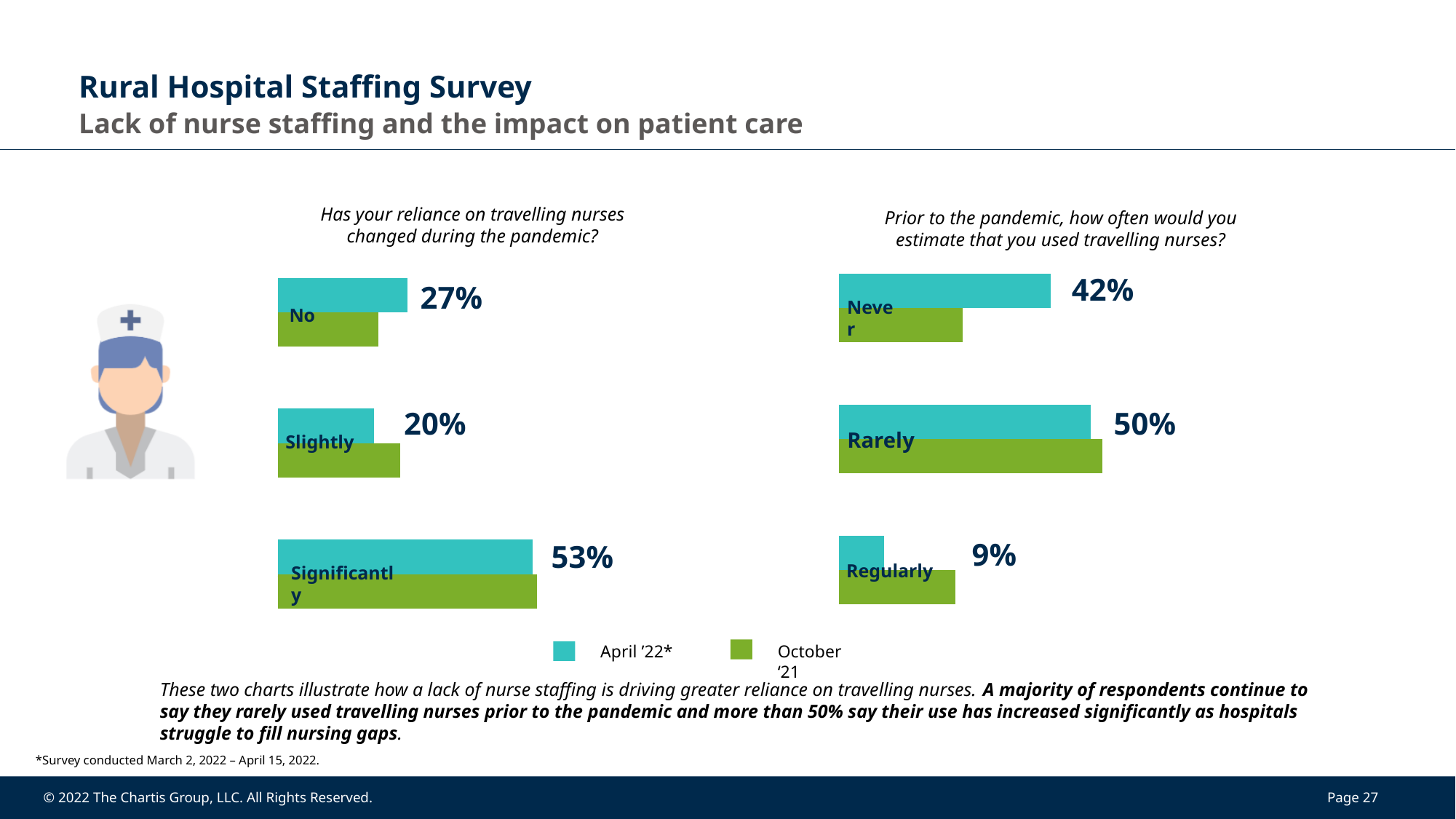
In the right chart (Prior to the pandemic, how often would you estimate that you used travelling nurses?), what is the April '22 value for Rarely? 50% In the left chart (Has your reliance on travelling nurses changed during the pandemic?), what is the April '22 value for No? 27% In the left chart (Has your reliance on travelling nurses changed during the pandemic?), which category has the highest labelled April '22 value? Significantly In the right chart (Prior to the pandemic, how often would you estimate that you used travelling nurses?), what is the difference between the labelled values for Rarely and Never? 8% In the right chart (Prior to the pandemic, how often would you estimate that you used travelling nurses?), which category has the lowest labelled April '22 value? Regularly In the left chart (Has your reliance on travelling nurses changed during the pandemic?), what is the April '22 value for Significantly? 53% How many series does the legend shared by the two charts list? 2 In the right chart (Prior to the pandemic, how often would you estimate that you used travelling nurses?), what is the April '22 value for Regularly? 9% What kind of chart is the right chart (Prior to the pandemic, how often would you estimate that you used travelling nurses?)? Bar chart In the right chart (Prior to the pandemic, how often would you estimate that you used travelling nurses?), which is larger for April '22: Never or Rarely? Rarely How many categories does the left chart (Has your reliance on travelling nurses changed during the pandemic?) show? 3 In the left chart (Has your reliance on travelling nurses changed during the pandemic?), what is the difference between the labelled values for Significantly and Slightly? 33%